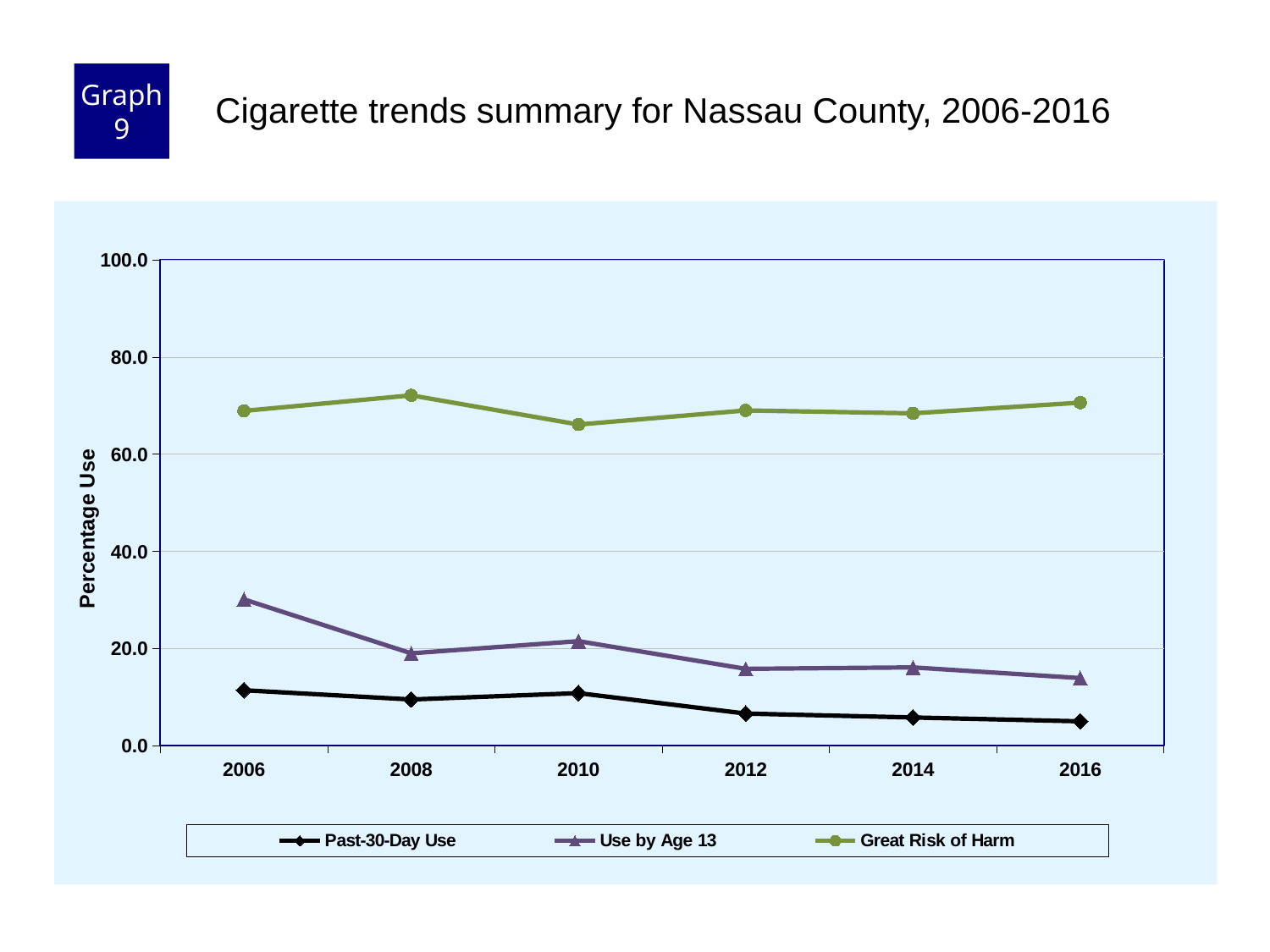
What is the title of the y axis? Percentage Use How many years are plotted along the x axis? 6 Is the value for Use by Age 13 in 2006 greater or less than 20.0? greater Is the value for Great Risk of Harm in 2008 greater or less than 80.0? less In 2010, which is larger: Use by Age 13 or Past-30-Day Use? Use by Age 13 In which year is Use by Age 13 at its highest? 2006 In which year is Great Risk of Harm at its lowest? 2010 Does Past-30-Day Use rise or fall overall from 2006 to 2016? fall Is the value for Great Risk of Harm in 2010 greater or less than 60.0? greater What kind of chart is shown on the slide? Line chart How many series does the legend list? 3